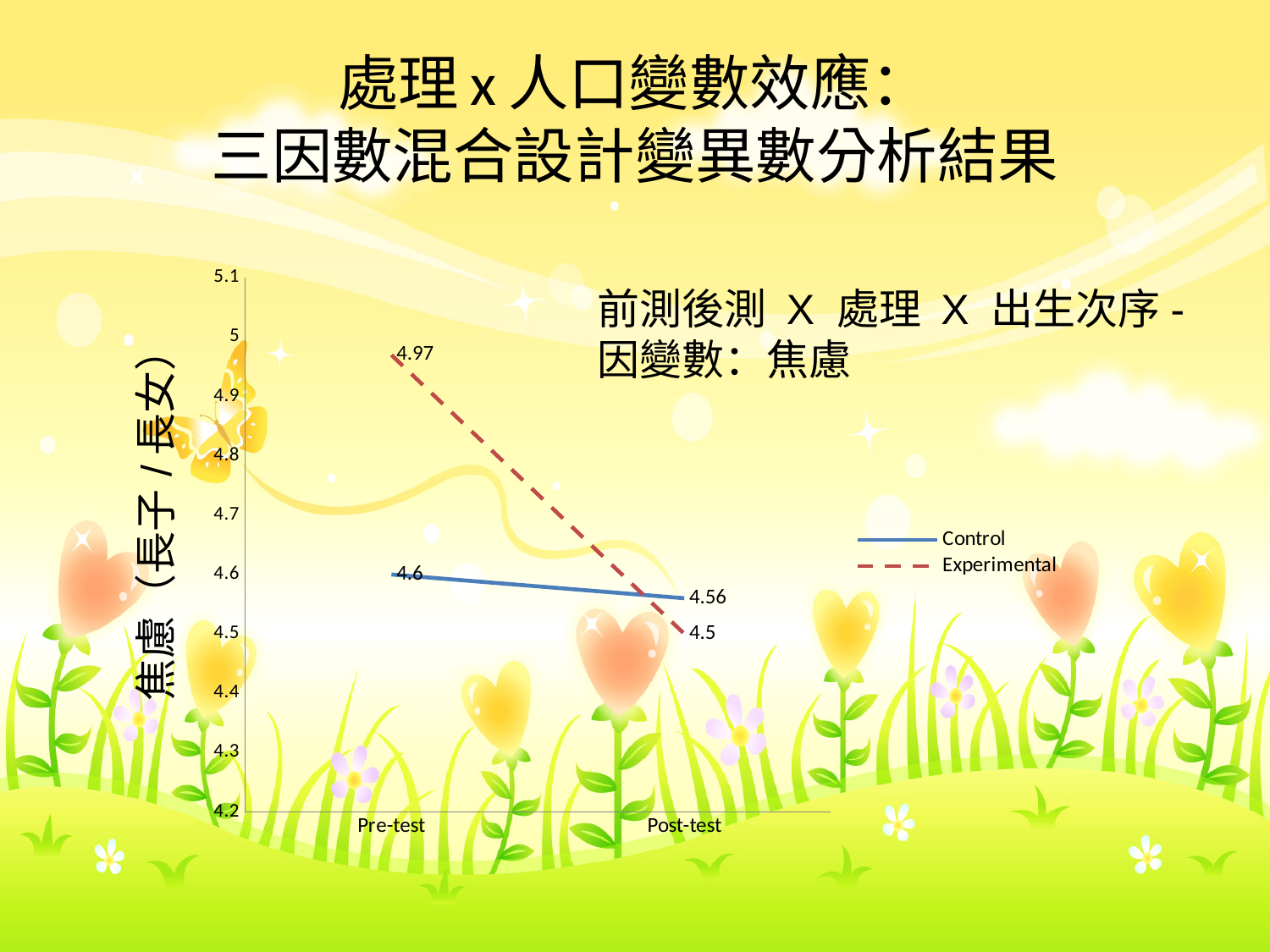
What is the value for the Control series at Post-test? 4.56 What is the value for the Experimental series at Post-test? 4.5 How many categories are shown on the x axis? 2 What is the value for the Control series at Pre-test? 4.6 Does the Experimental series rise or fall from Pre-test to Post-test? fall What is the difference between the Experimental values at Pre-test and Post-test? 0.47 What kind of chart is shown on the slide? line chart How many series does the legend list? 2 Which series has the higher value at Post-test, Control or Experimental? Control Which series has the higher value at Pre-test, Control or Experimental? Experimental What is the difference between the Control and Experimental values at Pre-test? 0.37 What is the value for the Experimental series at Pre-test? 4.97